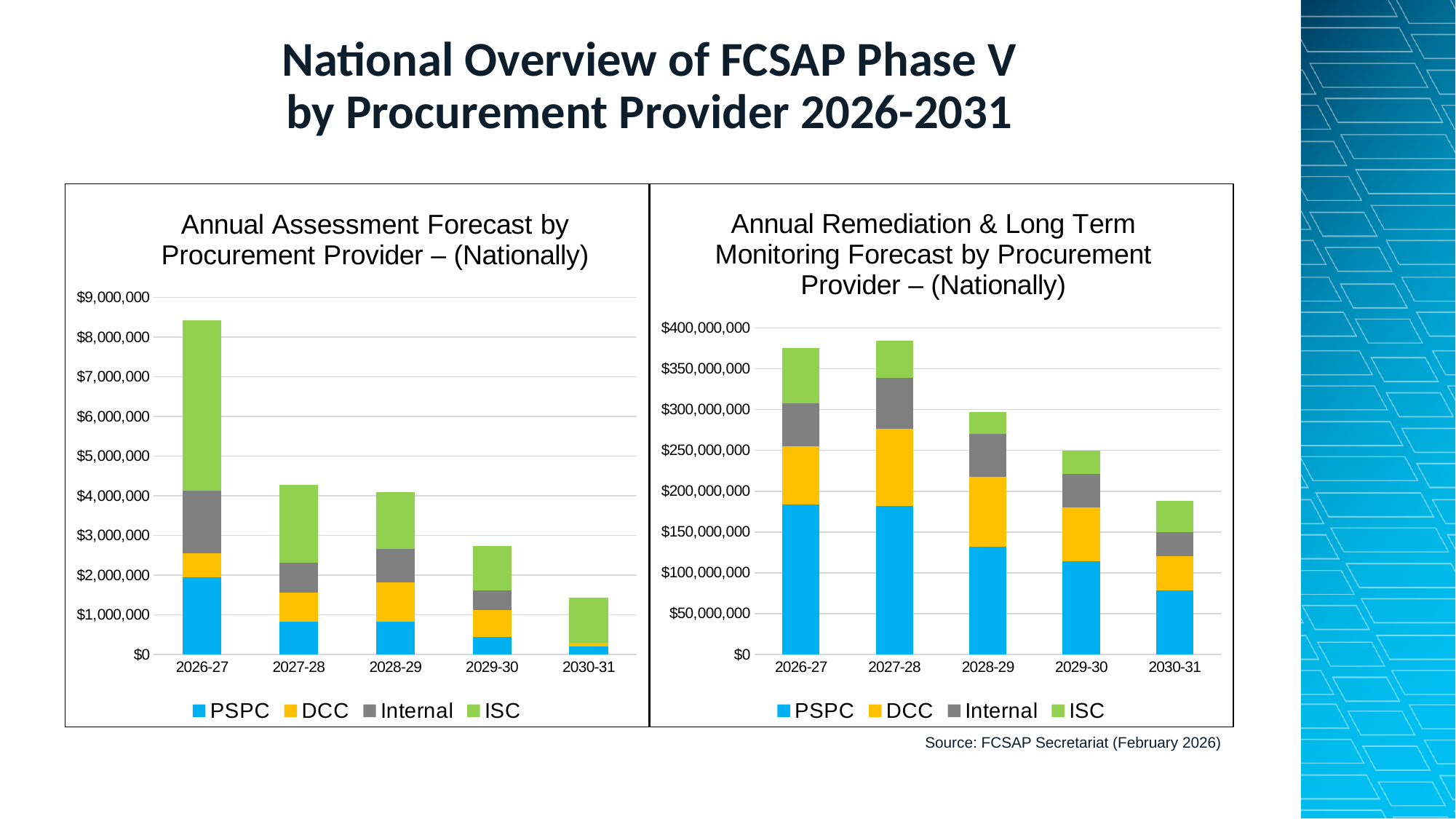
In the 'Annual Remediation & Long Term Monitoring Forecast' chart, is the total for 2030-31 greater or less than $200,000,000? less How many fiscal years are shown on the x axis of the 'Annual Assessment Forecast' chart? 5 In the 'Annual Assessment Forecast' chart, which year has the lowest total bar? 2030-31 In the 'Annual Remediation & Long Term Monitoring Forecast' chart, which year has the lowest total bar? 2030-31 In the 'Annual Remediation & Long Term Monitoring Forecast' chart, is the total for 2027-28 greater or less than $350,000,000? greater In the 'Annual Assessment Forecast' chart, is the total for 2026-27 greater or less than $8,000,000? greater In the 'Annual Assessment Forecast' chart, which year has the highest total bar? 2026-27 What kind of chart is the 'Annual Assessment Forecast by Procurement Provider – (Nationally)' chart? Stacked bar chart In the 'Annual Remediation & Long Term Monitoring Forecast' chart, do the total bars generally rise or fall from 2027-28 to 2030-31? Fall Which series is shown in green in both charts' legends? ISC In the 'Annual Assessment Forecast' chart, which total is larger: 2029-30 or 2030-31? 2029-30 How many series does the legend list in the 'Annual Remediation & Long Term Monitoring Forecast' chart? 4